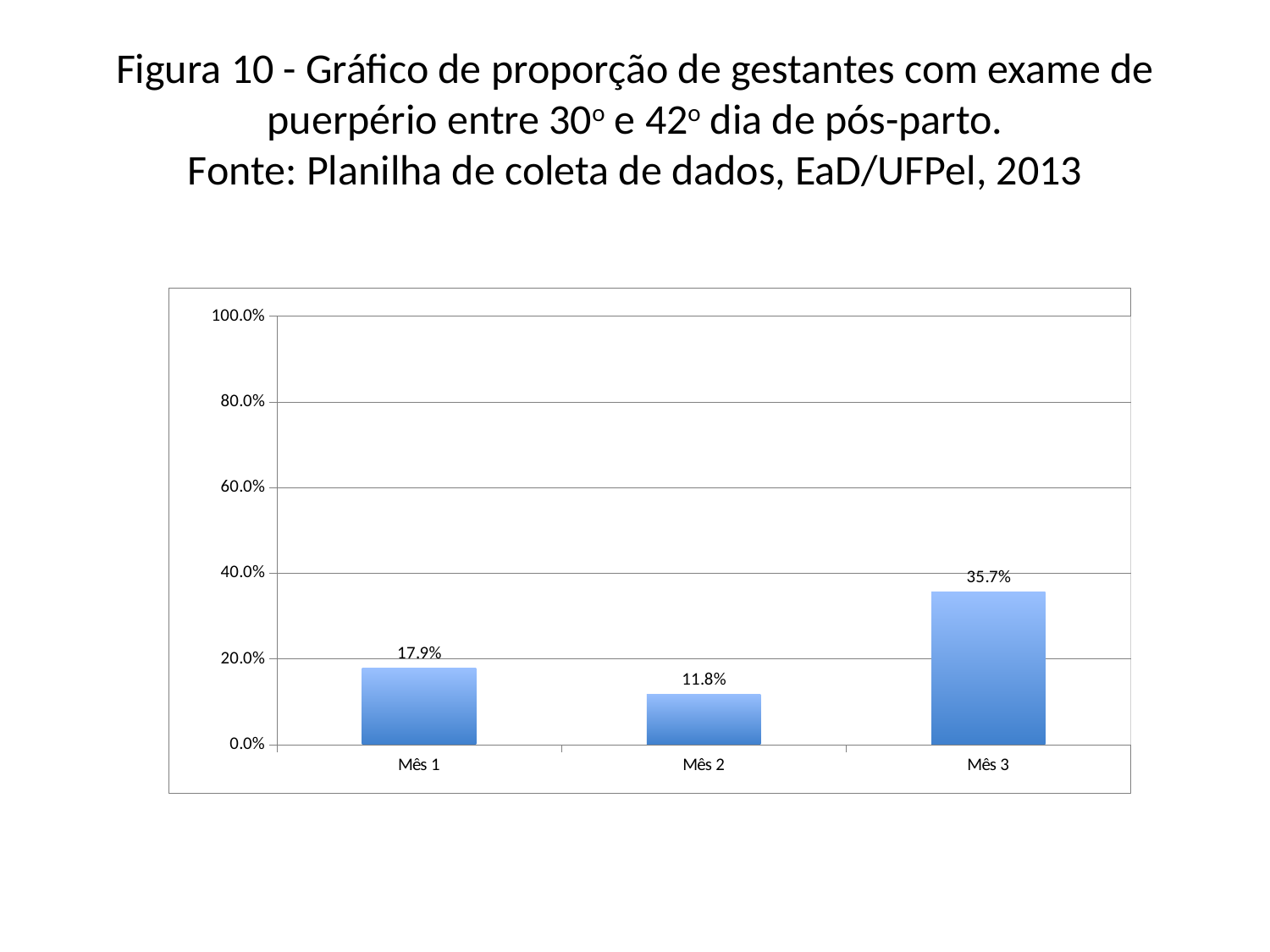
What is the difference between the values for Mês 1 and Mês 2? 6.1% What is the value for Mês 3? 35.7% What is the value for Mês 2? 11.8% Which month has the lowest value? Mês 2 Which month has the highest value? Mês 3 What is the maximum value shown on the y axis? 100.0% What kind of chart is shown on the slide? bar chart Which is larger, the value for Mês 1 or the value for Mês 2? Mês 1 Is the value for Mês 3 greater or less than 40.0%? less What is the difference between the values for Mês 3 and Mês 1? 17.8% What is the value for Mês 1? 17.9% How many months are shown on the x axis? 3